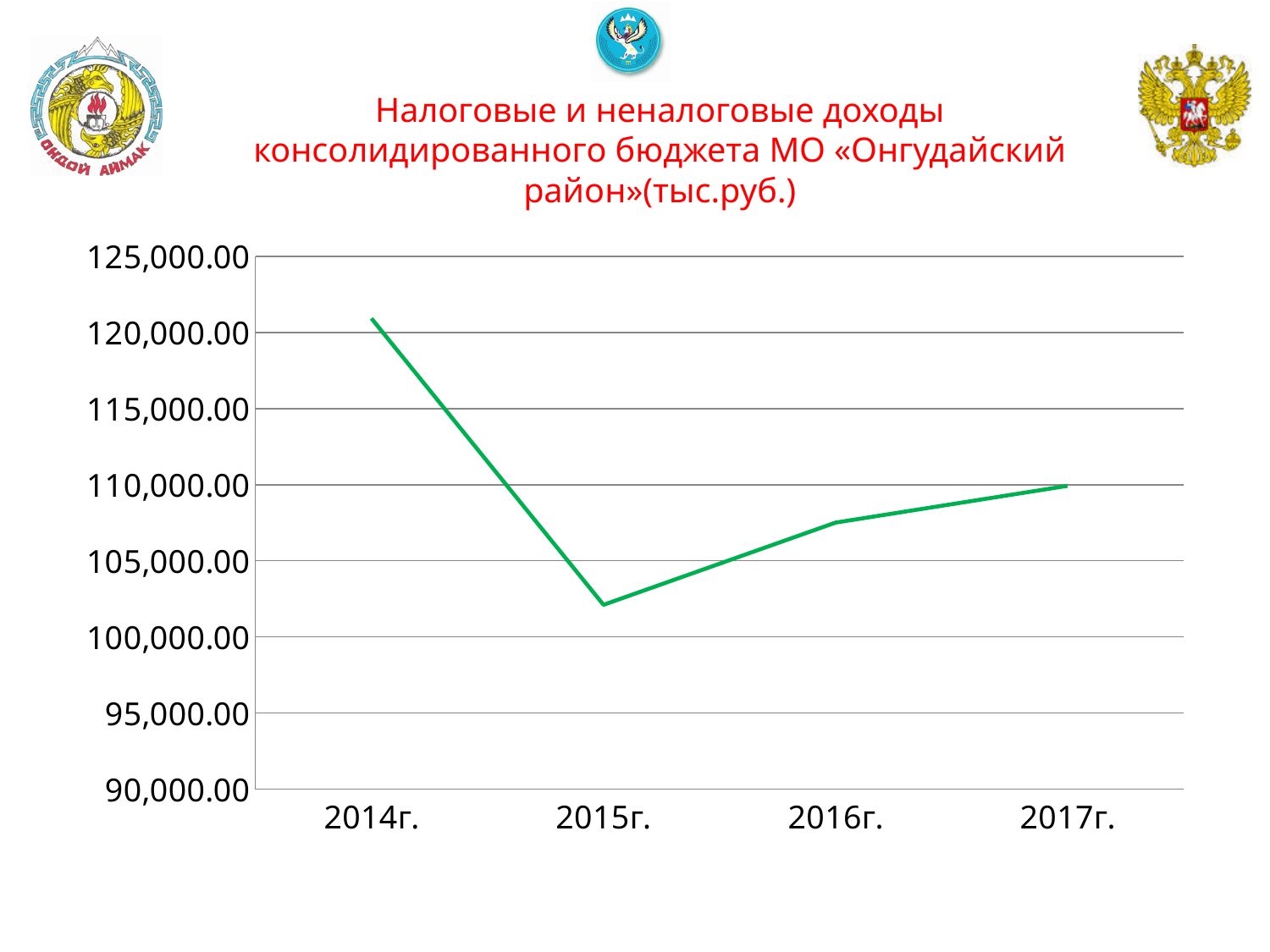
Is the value for 2014г. greater or less than 115,000.00? greater Does the value rise or fall from 2015г. to 2017г.? rise Is the value for 2015г. greater or less than 105,000.00? less Does the value rise or fall from 2014г. to 2015г.? fall How many years are plotted on the x axis of the chart? 4 In what units are the values on the chart expressed, according to the title? тыс.руб. What kind of chart is shown on the slide? line chart Which year has the lowest value on the chart? 2015г. Which year has the highest value on the chart? 2014г. Is the value for 2016г. greater or less than 105,000.00? greater Which is larger, the value for 2016г. or the value for 2017г.? 2017г. Which is larger, the value for 2014г. or the value for 2015г.? 2014г.